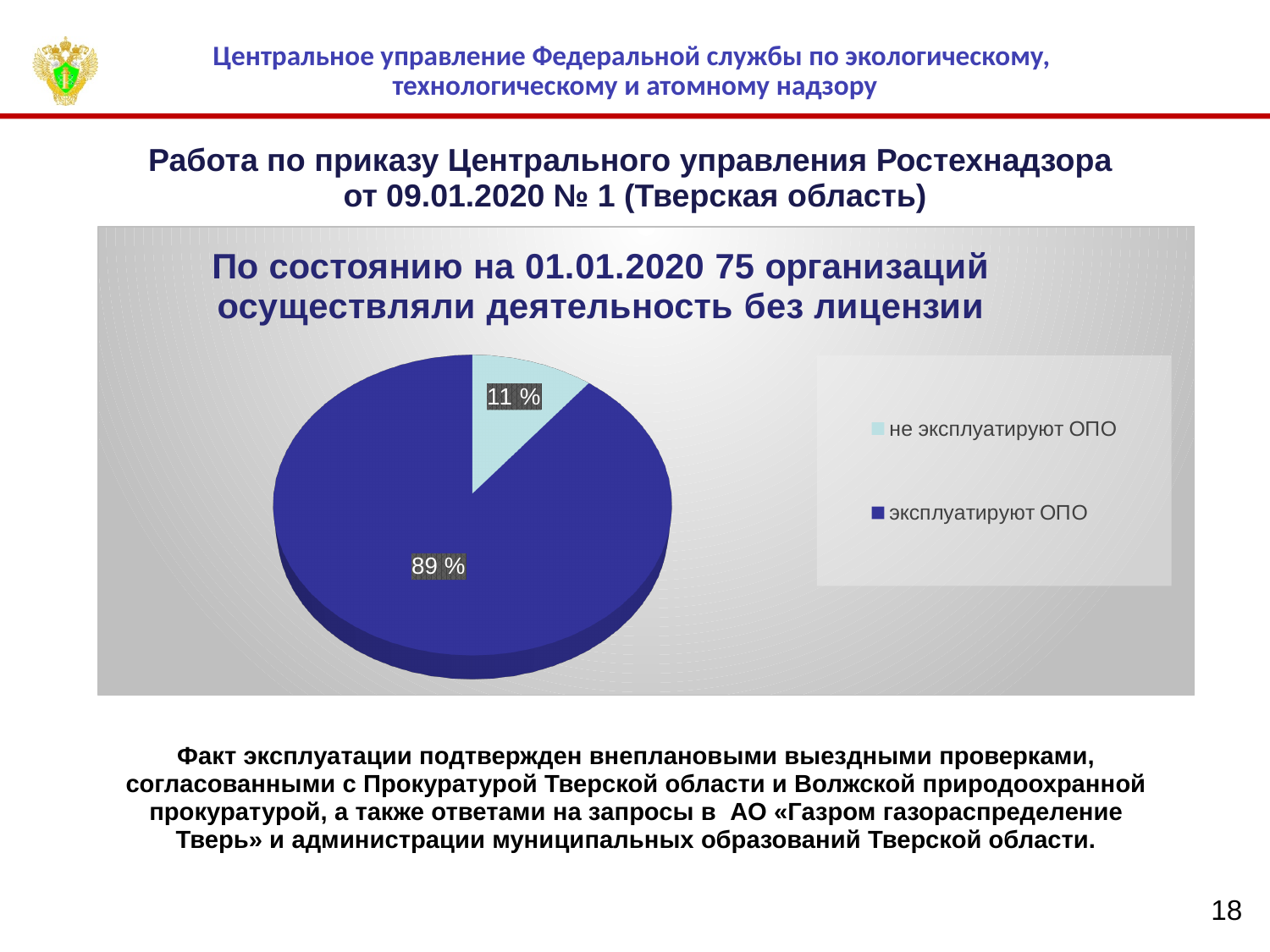
What colour is the slice for "не эксплуатируют ОПО"? light blue What share of the pie does "эксплуатируют ОПО" take? 89 % What kind of chart is shown on the slide? pie chart How many slices does the pie chart have? 2 What is the title of the chart? По состоянию на 01.01.2020 75 организаций осуществляли деятельность без лицензии What share of the pie does "не эксплуатируют ОПО" take? 11 % Which category has the smallest slice of the pie? не эксплуатируют ОПО What is the difference in percentage points between the "эксплуатируют ОПО" and "не эксплуатируют ОПО" slices? 78 Which is larger: the slice for "эксплуатируют ОПО" or the slice for "не эксплуатируют ОПО"? эксплуатируют ОПО How many entries does the legend list? 2 Which category has the largest slice of the pie? эксплуатируют ОПО